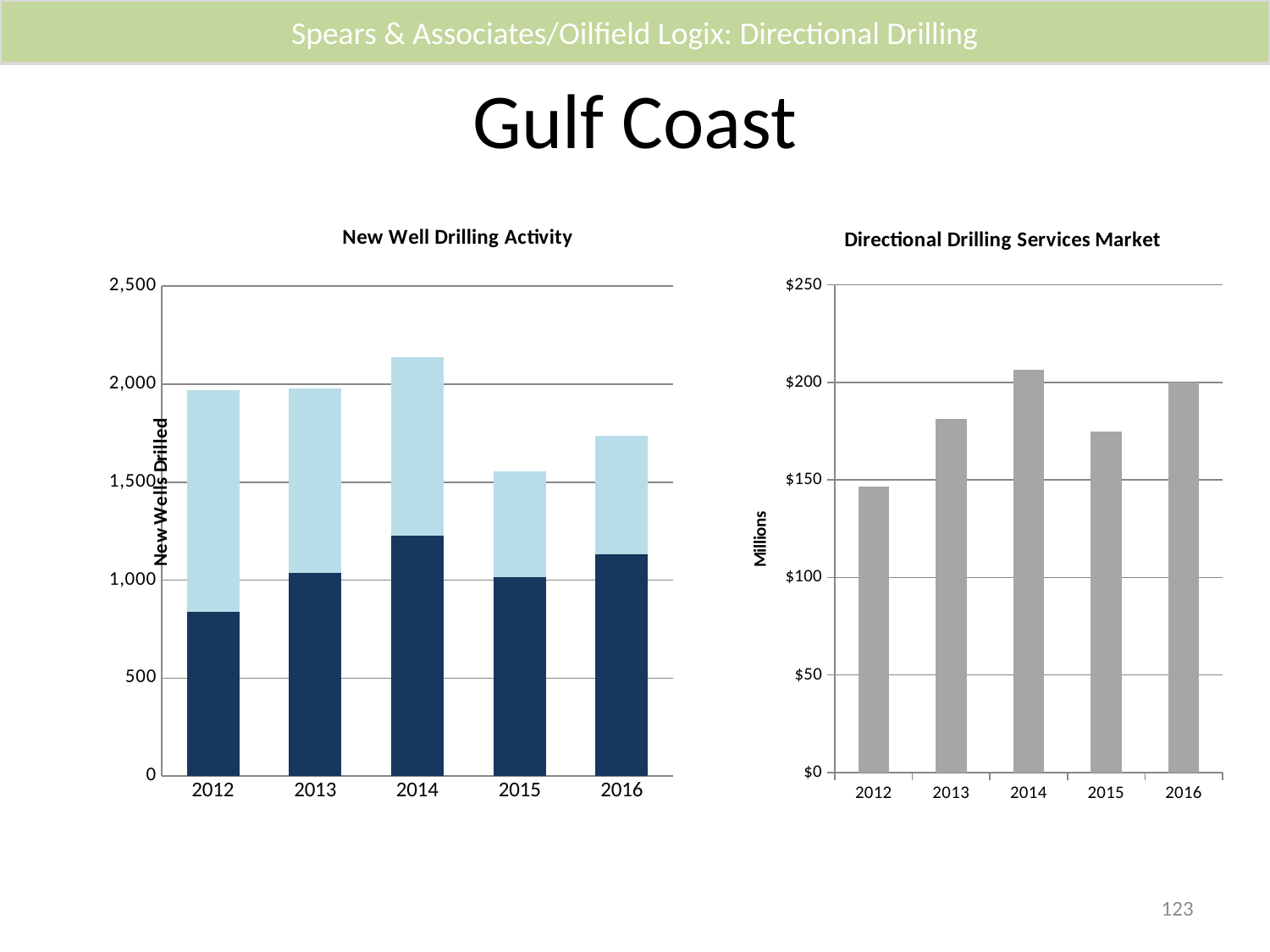
In the 'New Well Drilling Activity' chart, is the dark blue segment for 2012 greater or less than 1,000? less What is the y-axis label of the 'Directional Drilling Services Market' chart? Millions In the 'Directional Drilling Services Market' chart, which year has the highest value? 2014 In the 'Directional Drilling Services Market' chart, which year has the lowest value? 2012 What kind of chart is the 'New Well Drilling Activity' chart? stacked bar chart In the 'New Well Drilling Activity' chart, which year has the tallest total stacked bar? 2014 What kind of chart is the 'Directional Drilling Services Market' chart? bar chart In the 'New Well Drilling Activity' chart, which year has the shortest total stacked bar? 2015 In the 'New Well Drilling Activity' chart, is the total for 2014 greater or less than 2,000? greater How many years are shown on the x axis of the 'Directional Drilling Services Market' chart? 5 In the 'Directional Drilling Services Market' chart, is the value for 2014 greater or less than $200? greater